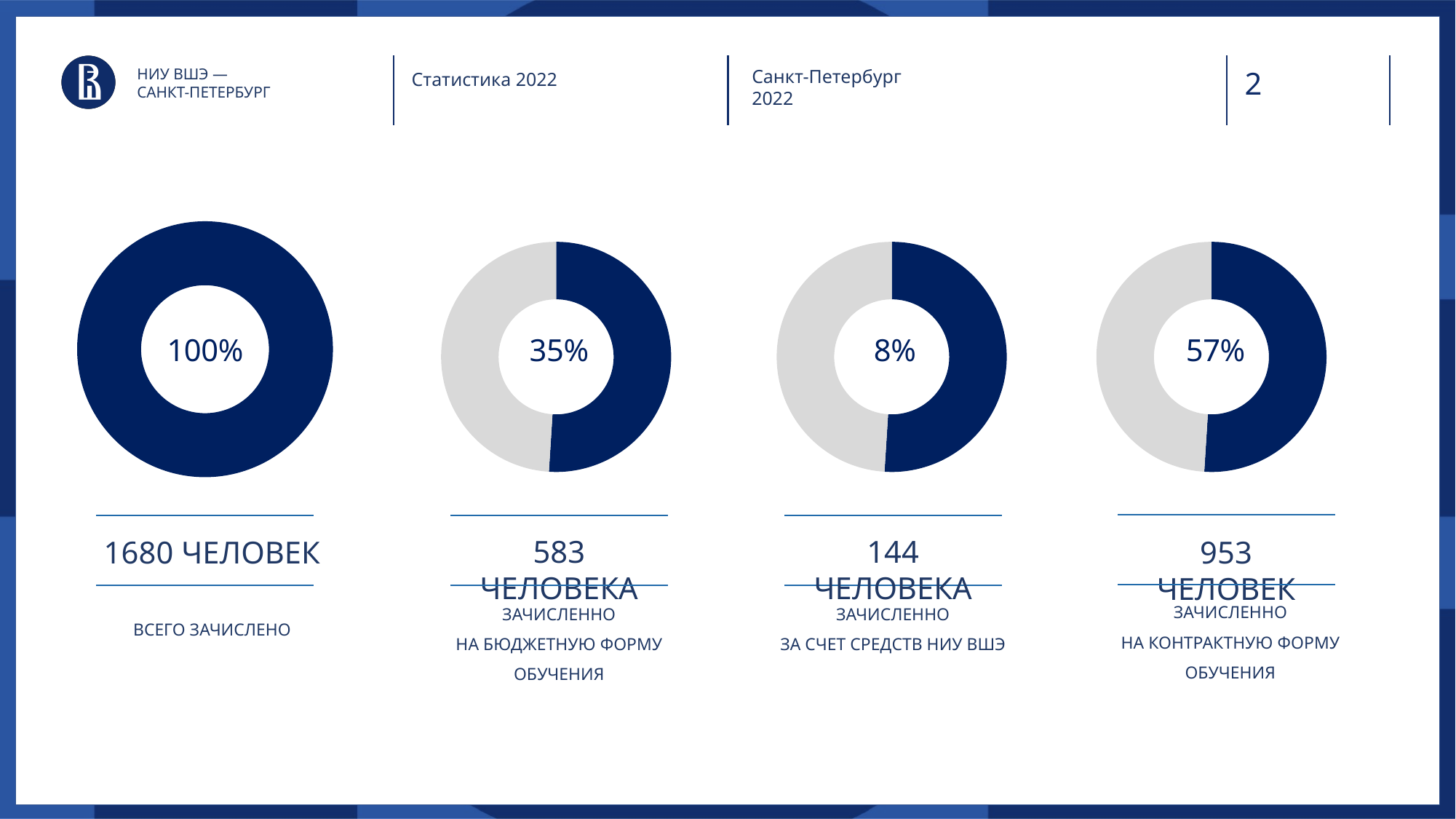
What percentage is shown in the centre of the leftmost donut chart (ВСЕГО ЗАЧИСЛЕНО)? 100% How many people in total were enrolled according to the leftmost chart (ВСЕГО ЗАЧИСЛЕНО)? 1680 ЧЕЛОВЕК Among the three partial donut charts (budget, HSE funds, contract), which category has the smallest share? ЗАЧИСЛЕНО ЗА СЧЕТ СРЕДСТВ НИУ ВШЭ (8%) What percentage is shown in the rightmost donut chart (ЗАЧИСЛЕНО НА КОНТРАКТНУЮ ФОРМУ ОБУЧЕНИЯ)? 57% What percentage is shown in the third donut chart from the left (ЗАЧИСЛЕНО ЗА СЧЕТ СРЕДСТВ НИУ ВШЭ)? 8% Among the three partial donut charts (budget, HSE funds, contract), which category has the largest share? ЗАЧИСЛЕНО НА КОНТРАКТНУЮ ФОРМУ ОБУЧЕНИЯ (57%) How many people were enrolled on the contract form of study according to the rightmost chart? 953 ЧЕЛОВЕК What kind of charts are shown on the slide? Donut (pie) charts What is the difference in percentage points between the contract form chart (57%) and the budget form chart (35%)? 22 percentage points Which is larger: the number of people enrolled on the budget form (583) or the number enrolled at the expense of HSE funds (144)? Budget form (583) What percentage is shown in the second donut chart from the left (ЗАЧИСЛЕНО НА БЮДЖЕТНУЮ ФОРМУ ОБУЧЕНИЯ)? 35% How many donut charts are on the slide? 4